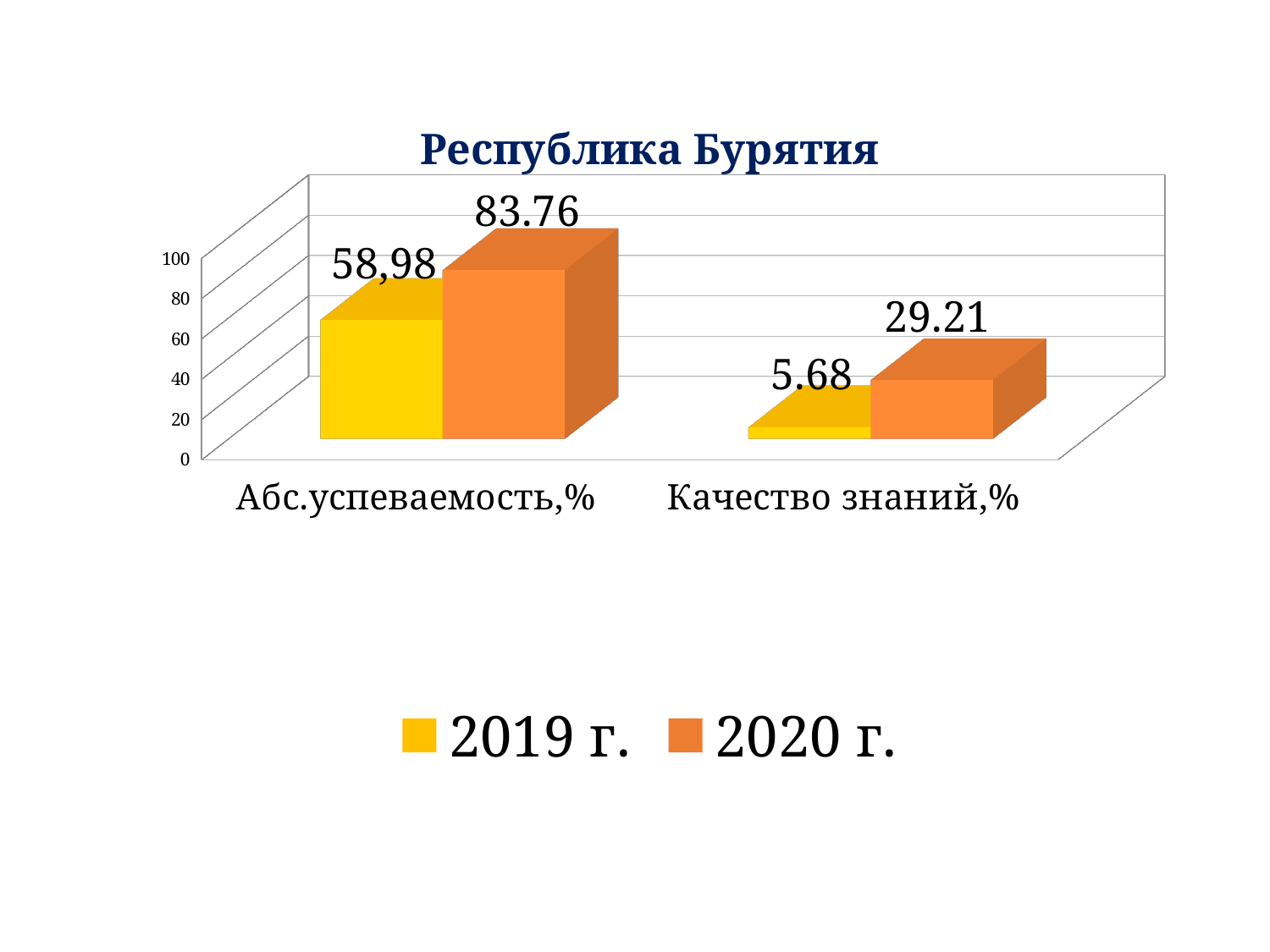
How many series does the legend list? 2 How many categories are shown on the x axis? 2 What is the value for 2020 г. in the Абс.успеваемость,% category? 83.76 What is the value for 2020 г. in the Качество знаний,% category? 29.21 Which bar has the lowest value on the chart? 2019 г., Качество знаний,% What is the title of the chart? Республика Бурятия Which bar has the highest value on the chart? 2020 г., Абс.успеваемость,% What is the value for 2019 г. in the Качество знаний,% category? 5.68 What is the difference between the 2020 г. and 2019 г. values for Качество знаний,%? 23.53 What is the value for 2019 г. in the Абс.успеваемость,% category? 58,98 Which is larger for Абс.успеваемость,%: the 2019 г. value or the 2020 г. value? 2020 г. What kind of chart is shown on the slide? Bar chart